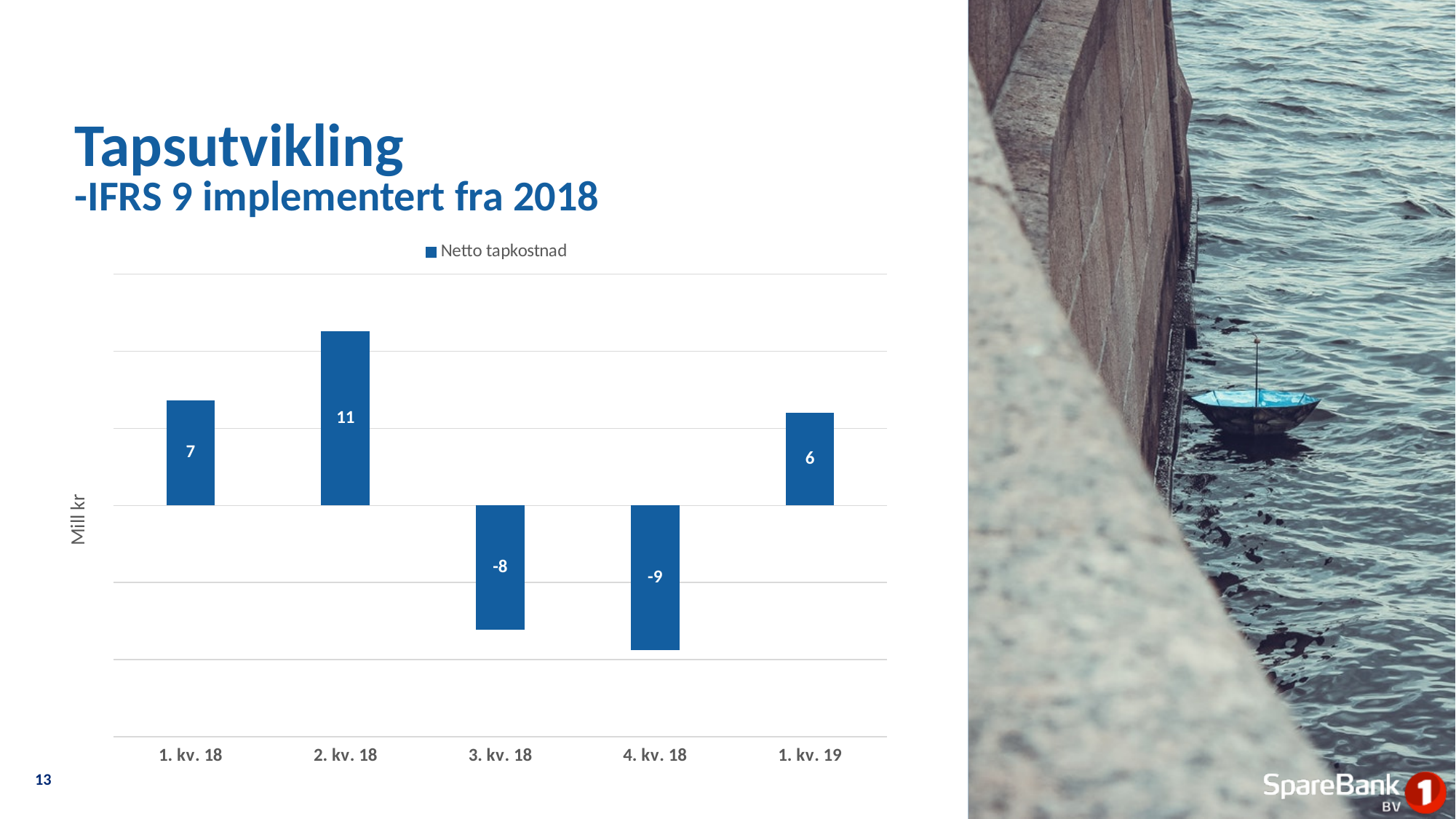
What is the difference between the values for 2. kv. 18 and 1. kv. 18? 4 What is the value for 2. kv. 18? 11 What series name does the legend show? Netto tapkostnad Which quarter has the lowest value? 4. kv. 18 What is the value for 1. kv. 19? 6 Which quarter has the highest value? 2. kv. 18 What is the value for 1. kv. 18? 7 How many quarters are shown on the x axis? 5 What is the value for 3. kv. 18? -8 What kind of chart is shown? Bar chart Which is larger, the value for 1. kv. 18 or the value for 1. kv. 19? 1. kv. 18 What is the value for 4. kv. 18? -9